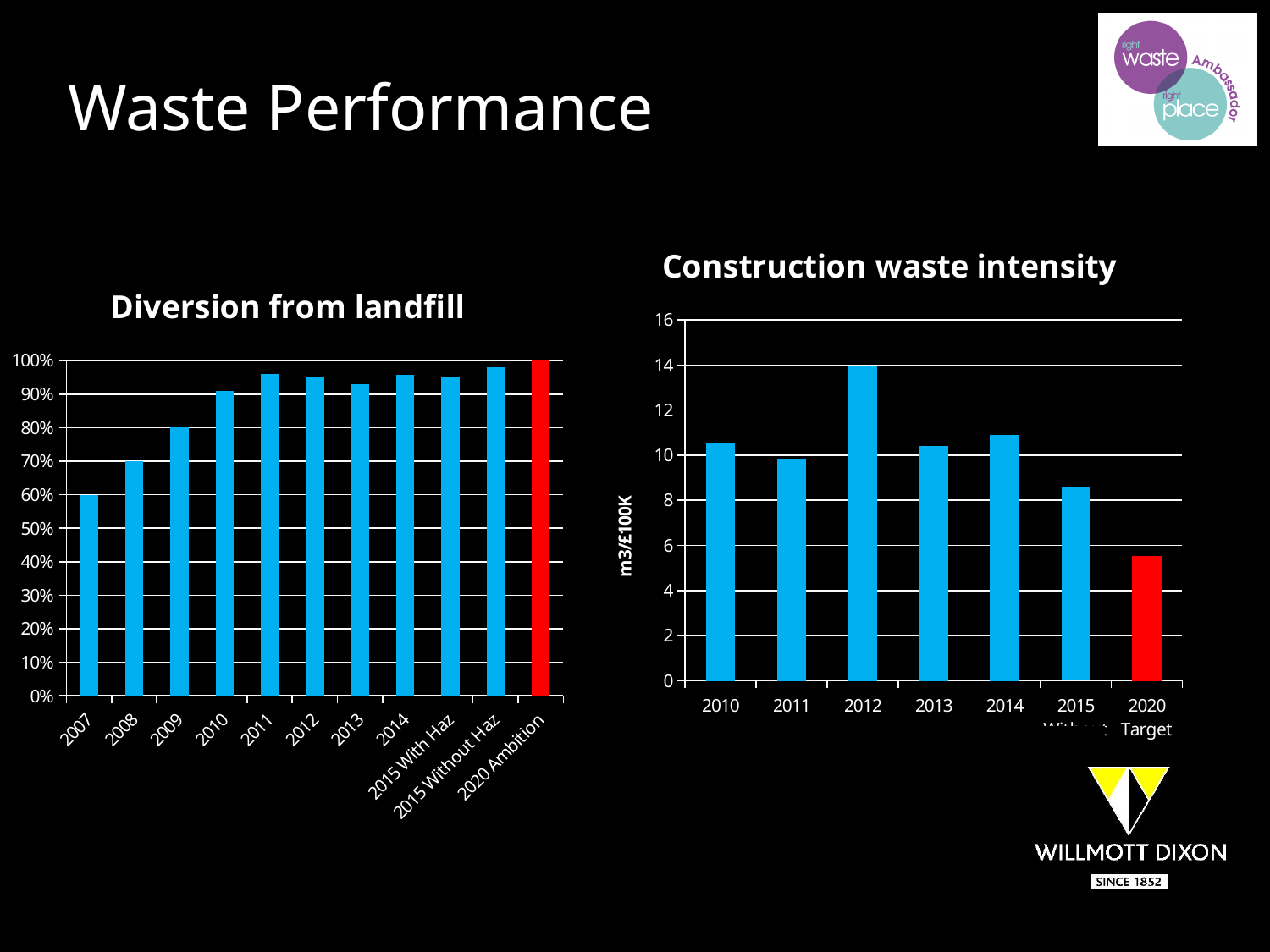
In the 'Construction waste intensity' chart, which year has the highest value? 2012 In the 'Construction waste intensity' chart, which category has the lowest value? 2020 Target In the 'Diversion from landfill' chart, is the value for 2007 greater or less than 50%? greater How many bars are shown in the 'Construction waste intensity' chart? 7 In the 'Diversion from landfill' chart, which category has the highest value? 2020 Ambition In the 'Construction waste intensity' chart, is the value for 2012 greater or less than 12? greater In the 'Diversion from landfill' chart, which category has the lowest value? 2007 In the 'Diversion from landfill' chart, is the value for 2009 greater or less than 90%? less What is the y-axis label of the 'Construction waste intensity' chart? m3/£100K In the 'Diversion from landfill' chart, what is the value for 2020 Ambition? 100% What kind of chart is the 'Diversion from landfill' chart? bar chart How many categories are shown on the x axis of the 'Diversion from landfill' chart? 11